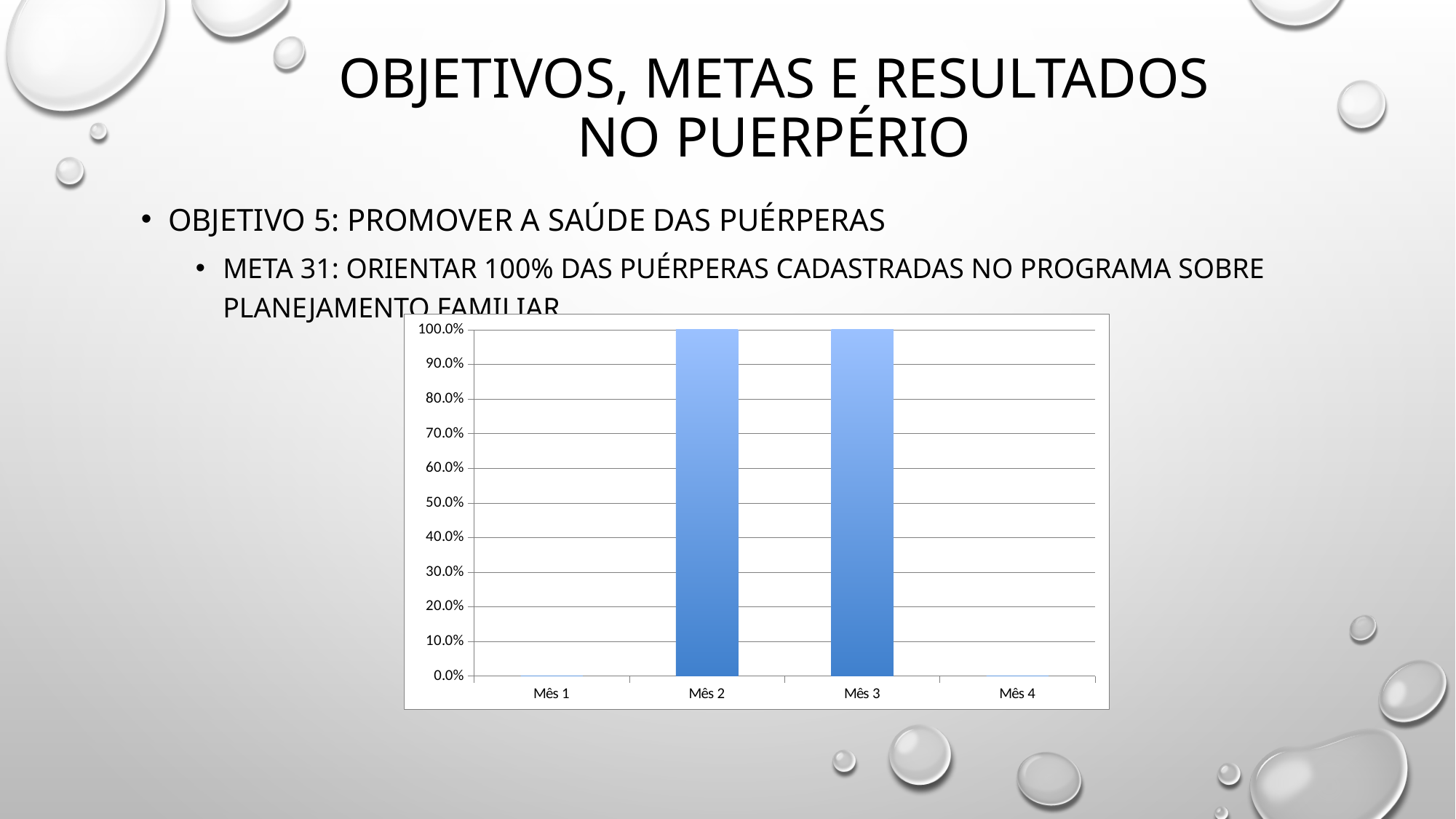
What is the value for Mês 1? 0.0% What kind of chart is shown on the slide? bar chart What is the value for Mês 2? 100.0% What is the value for Mês 4? 0.0% What is the label of the first category on the x axis? Mês 1 How many categories are shown on the x axis of the chart? 4 Is the value for Mês 3 greater or less than 50.0%? greater Is the value for Mês 1 greater or less than 10.0%? less What is the difference between the value for Mês 2 and the value for Mês 1? 100.0% What is the value for Mês 3? 100.0% What is the highest value shown on the y axis of the chart? 100.0% Which is larger, the value for Mês 2 or the value for Mês 4? Mês 2